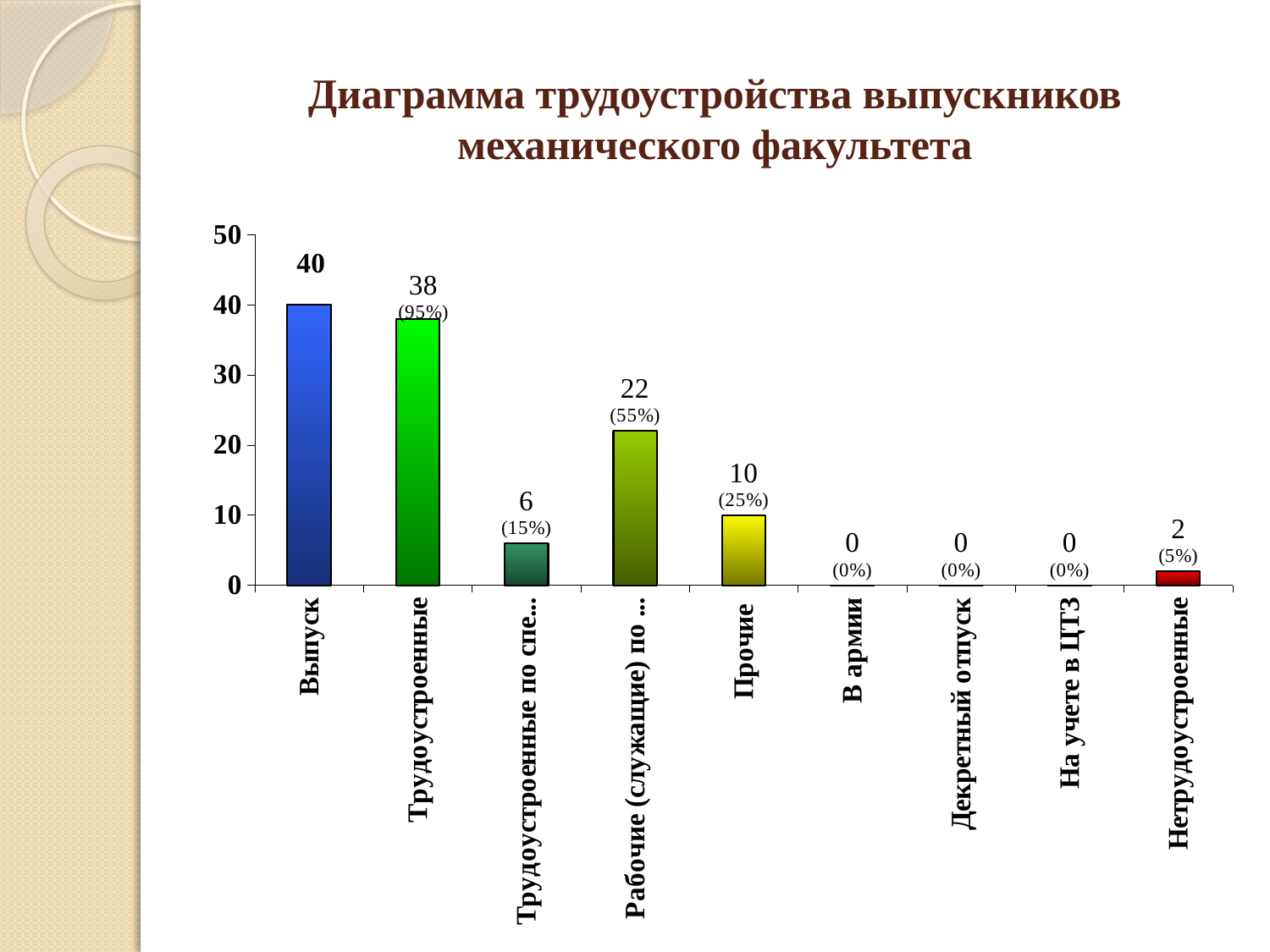
Which is larger, the value for Прочие or the value for Нетрудоустроенные? Прочие What percentage is shown for Прочие? 25% What type of chart is shown on the slide? bar chart What percentage is shown for Нетрудоустроенные? 5% What is the value for Нетрудоустроенные? 2 What is the title of the chart? Диаграмма трудоустройства выпускников механического факультета Which category has the highest value? Выпуск What is the value for Выпуск? 40 How many categories are shown on the x axis? 9 What is the difference between the values for Выпуск and Трудоустроенные? 2 What is the difference between the values for Трудоустроенные and Нетрудоустроенные? 36 What is the value for Трудоустроенные? 38